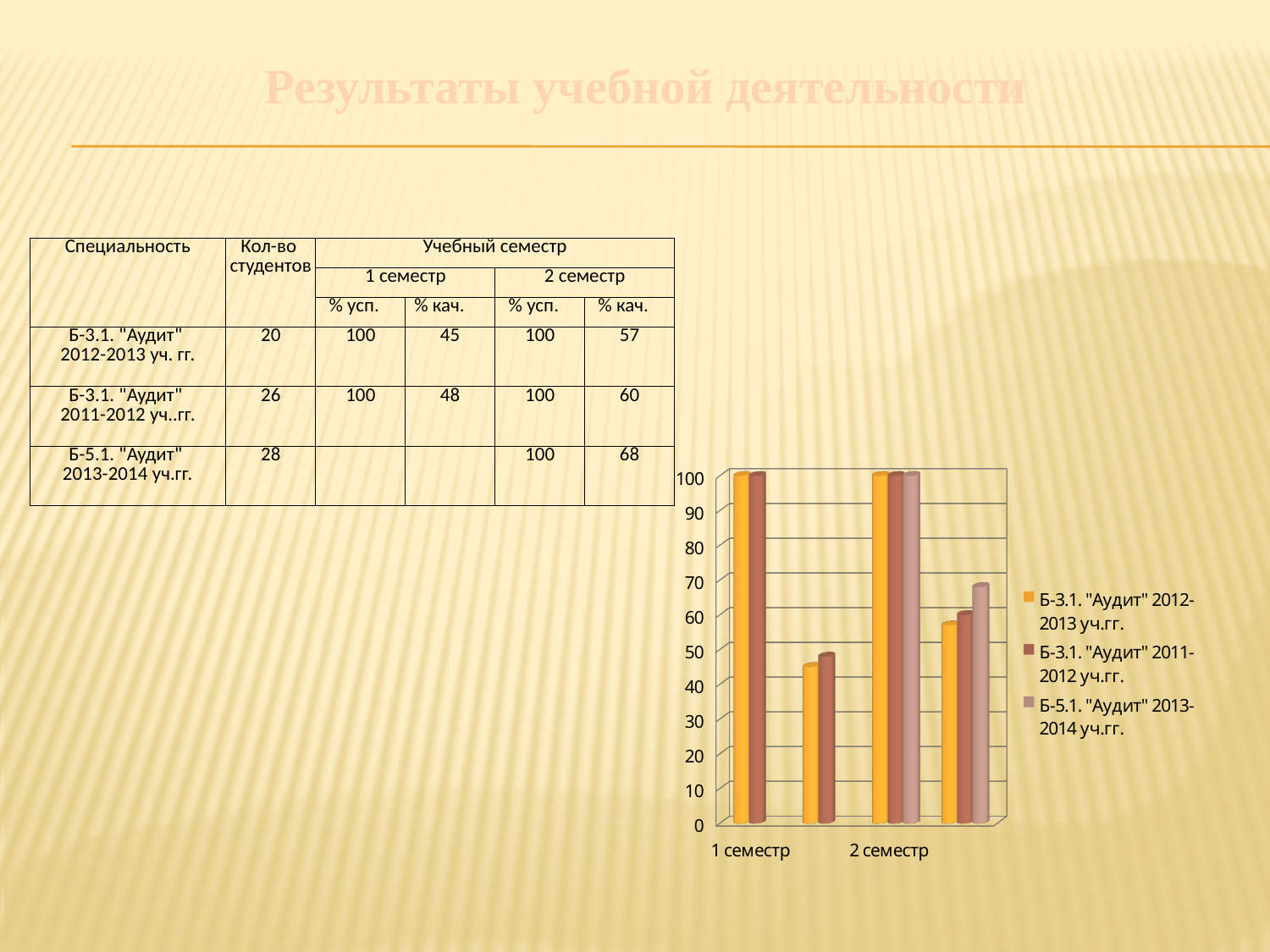
In the rightmost cluster of the chart, which series has the tallest bar? Б-5.1. "Аудит" 2013-2014 уч.гг. In the second cluster from the left, is the bar for Б-3.1. "Аудит" 2012-2013 уч.гг. greater or less than 50? less What are the two category labels shown on the chart's x axis? 1 семестр, 2 семестр Which series has no bars in the 1 семестр part of the chart? Б-5.1. "Аудит" 2013-2014 уч.гг. In the rightmost cluster of the chart, is the bar for Б-5.1. "Аудит" 2013-2014 уч.гг. greater or less than 60? greater How many bars are in the leftmost cluster of the chart? 2 How many clusters of bars are plotted in the chart? 4 What are the three series listed in the chart legend? Б-3.1. "Аудит" 2012-2013 уч.гг.; Б-3.1. "Аудит" 2011-2012 уч.гг.; Б-5.1. "Аудит" 2013-2014 уч.гг. How many series does the chart legend list? 3 What value do the tallest bars in the chart reach on the vertical axis? 100 What type of chart is shown on the slide? bar chart